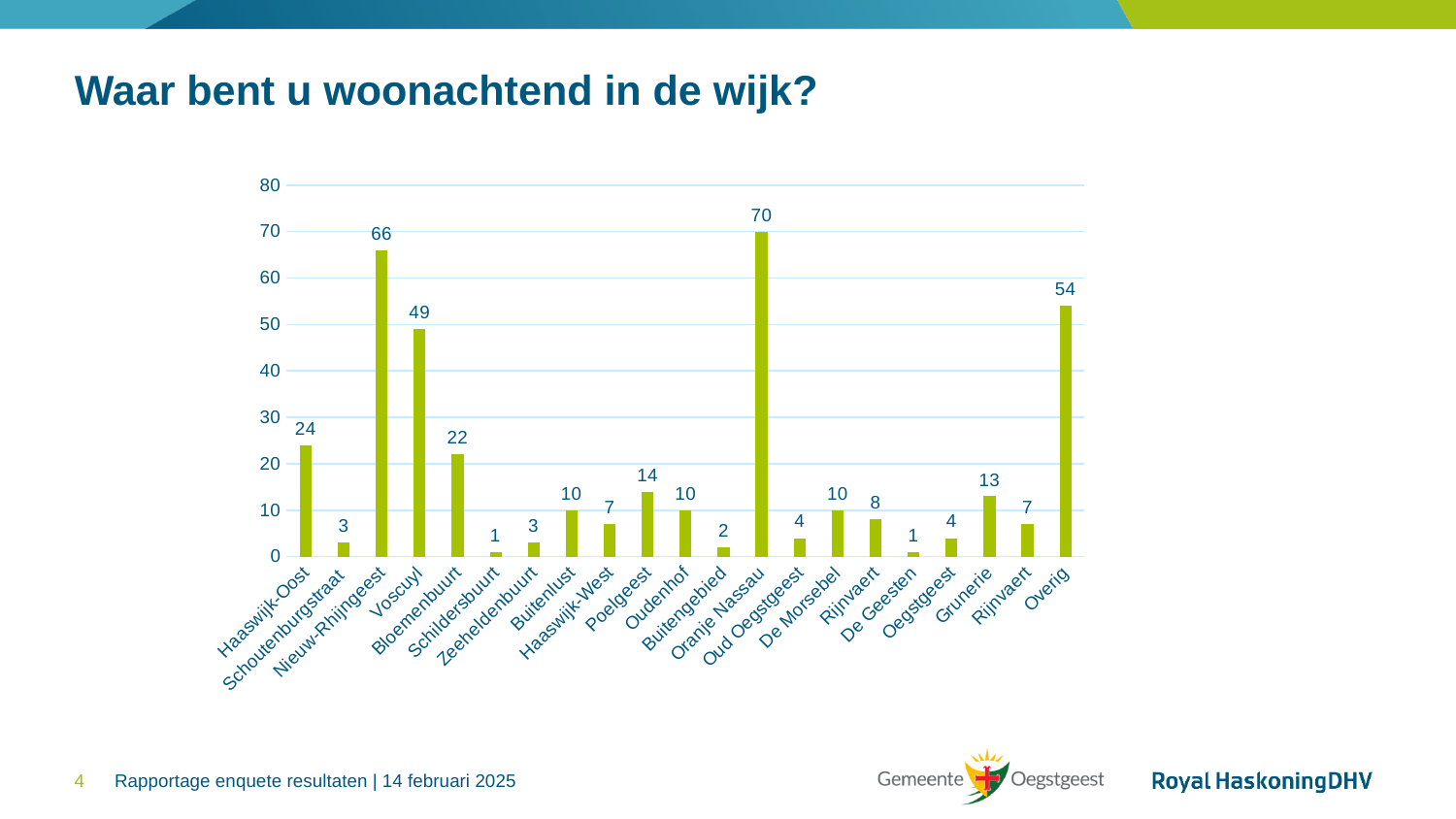
What is the difference between the values for Oranje Nassau and Nieuw-Rhijngeest? 4 Which category has the highest value? Oranje Nassau What is the value for Oranje Nassau? 70 What is the value for Nieuw-Rhijngeest? 66 What is the difference between the values for Voscuyl and Bloemenbuurt? 27 How many categories are shown on the x axis? 21 Which is larger, the value for Poelgeest or the value for Oudenhof? Poelgeest What kind of chart is shown on the slide? Bar chart What is the title of the chart on the slide? Waar bent u woonachtend in de wijk? What is the value for Haaswijk-Oost? 24 What is the value for Overig? 54 What is the value for Grunerie? 13